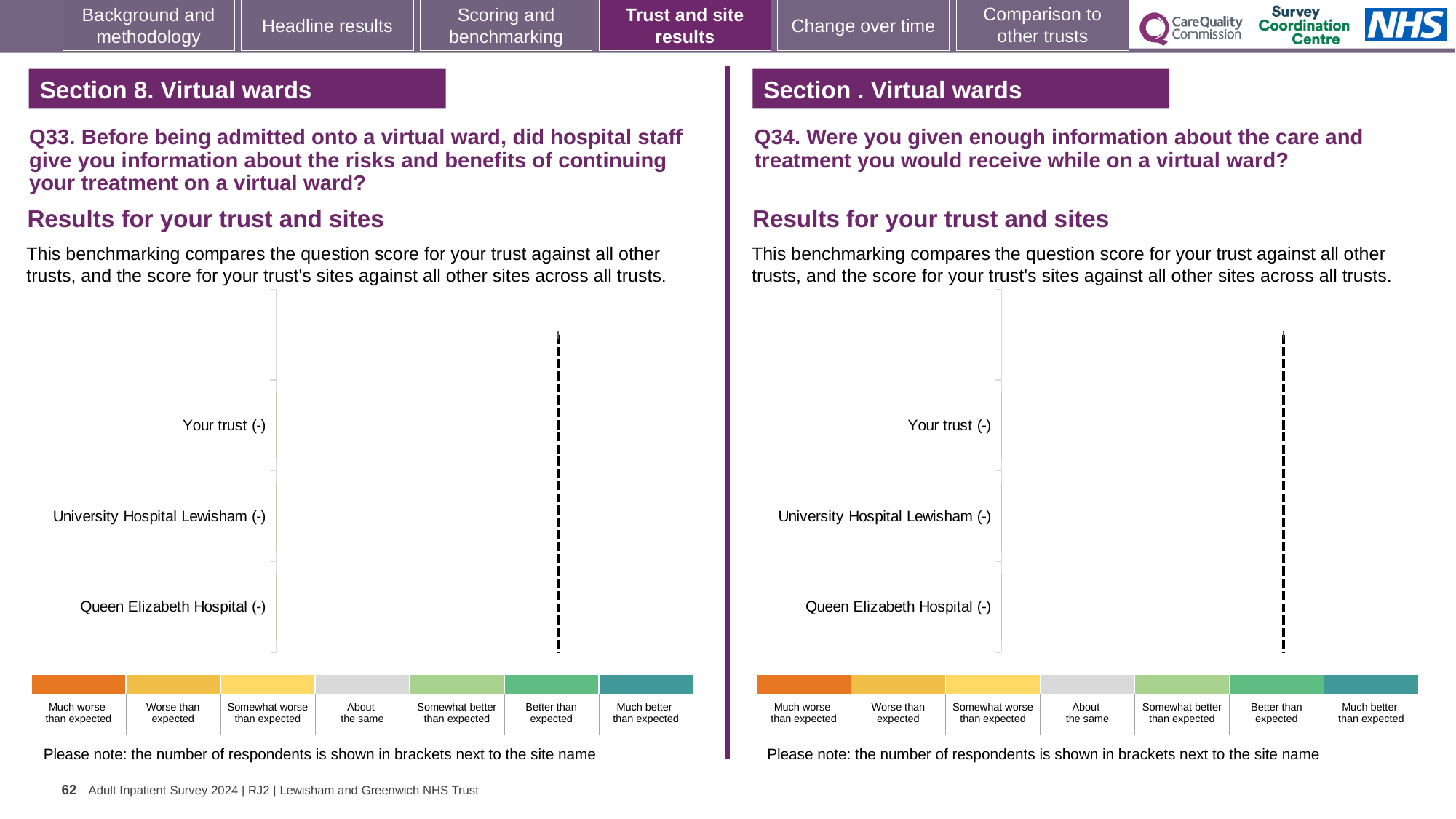
On the left chart (Q33), are any bars plotted for the three rows? No On the left chart (Q33), how many colour bands does the legend below the chart show? 7 On the right chart (Q34), are any bars plotted for the three rows? No On the right chart (Q34), what is the label of the bottom row? Queen Elizabeth Hospital (-) On the right chart (Q34), what is shown in brackets next to Your trust? - On the right chart (Q34), how many sites or trust rows are listed on the vertical axis? 3 On the left chart (Q33), what is shown in brackets next to University Hospital Lewisham? - On the left chart (Q33), how many sites or trust rows are listed on the vertical axis? 3 On the right chart (Q34), how many colour bands does the legend below the chart show? 7